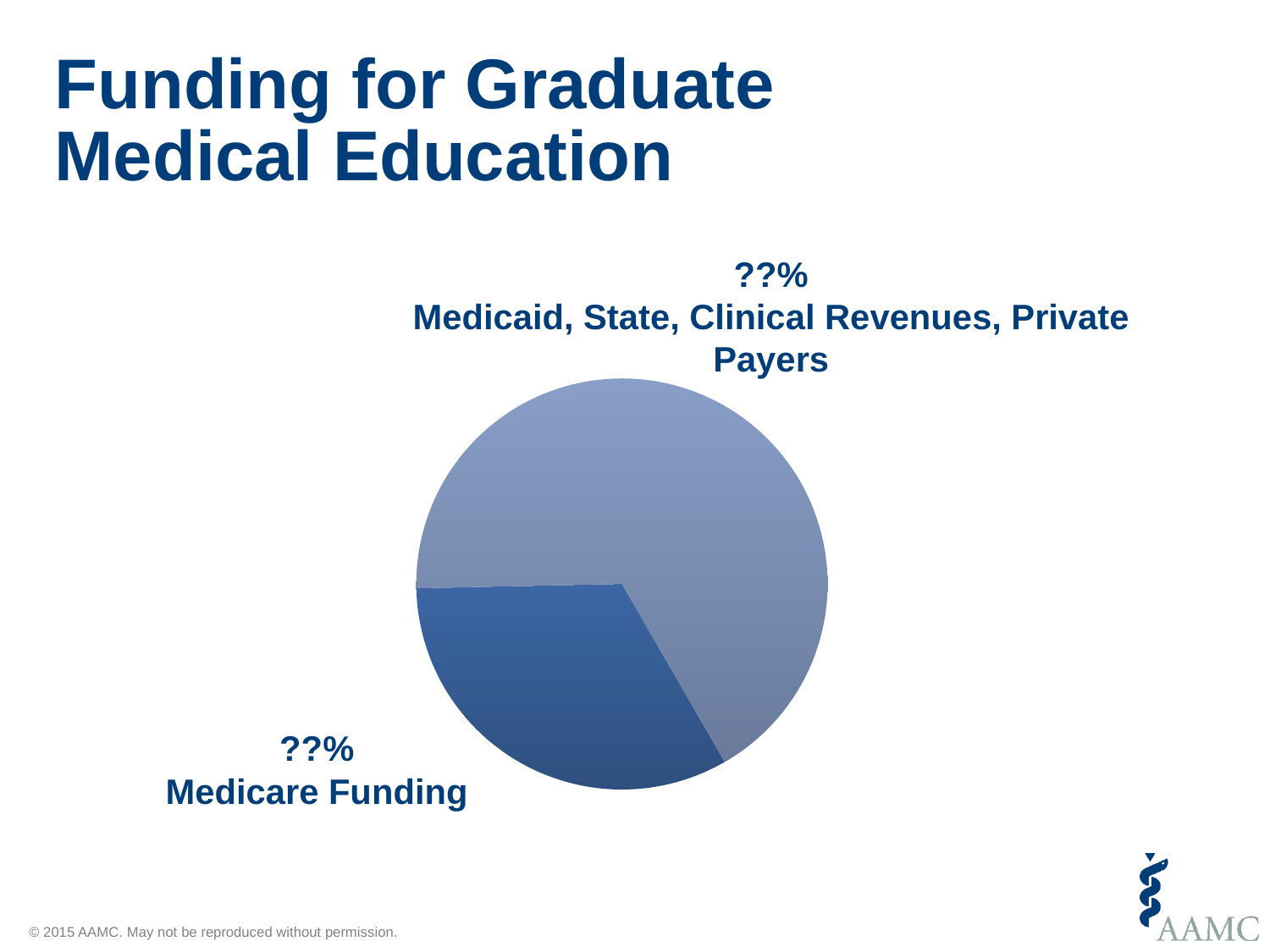
Does the Medicare Funding slice make up more or less than half of the pie? Less What kind of chart is shown on the slide? Pie chart Which is larger in the pie chart: the Medicare Funding slice or the Medicaid, State, Clinical Revenues, Private Payers slice? Medicaid, State, Clinical Revenues, Private Payers How many slices does the pie chart have? 2 What percentage value is printed for the Medicaid, State, Clinical Revenues, Private Payers slice? ??% What percentage value is printed for the Medicare Funding slice? ??% Which slice of the pie chart is the largest? Medicaid, State, Clinical Revenues, Private Payers Which slice of the pie chart is the smallest? Medicare Funding What is the title of the slide containing the pie chart? Funding for Graduate Medical Education Which slice of the pie chart is shown in the darker blue colour? Medicare Funding